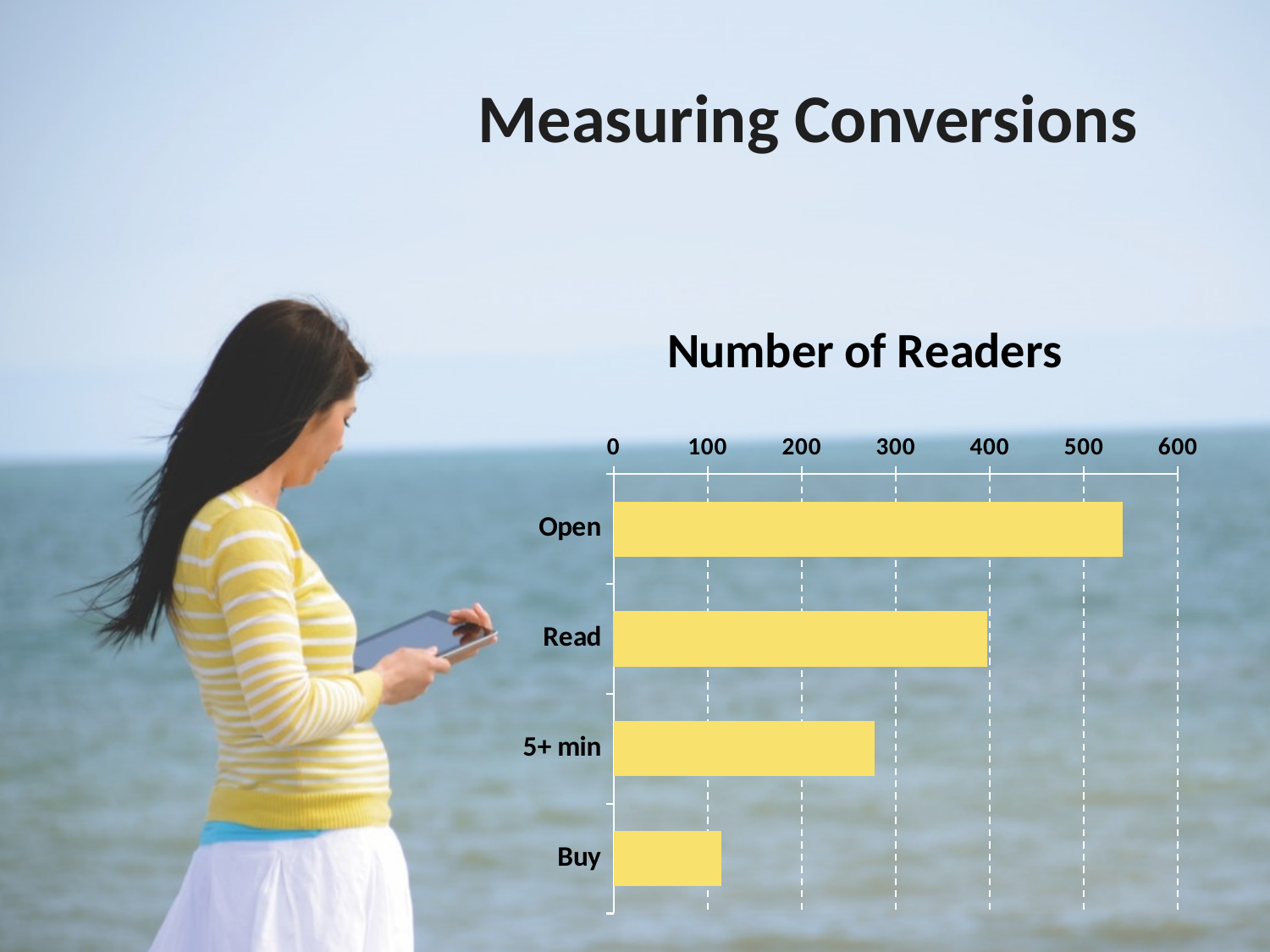
What type of chart is shown on the slide? bar chart What is the title of the chart? Number of Readers Do the values rise or fall going from Open down to Buy? fall Which category has the highest number of readers? Open Is the value for 5+ min greater or less than 200? greater How many categories are shown in the chart? 4 Is the value for Buy greater or less than 200? less Is the value for Read greater or less than 300? greater What colour are the bars in the chart? yellow Which is larger, the value for Read or the value for 5+ min? Read Which category has the lowest number of readers? Buy